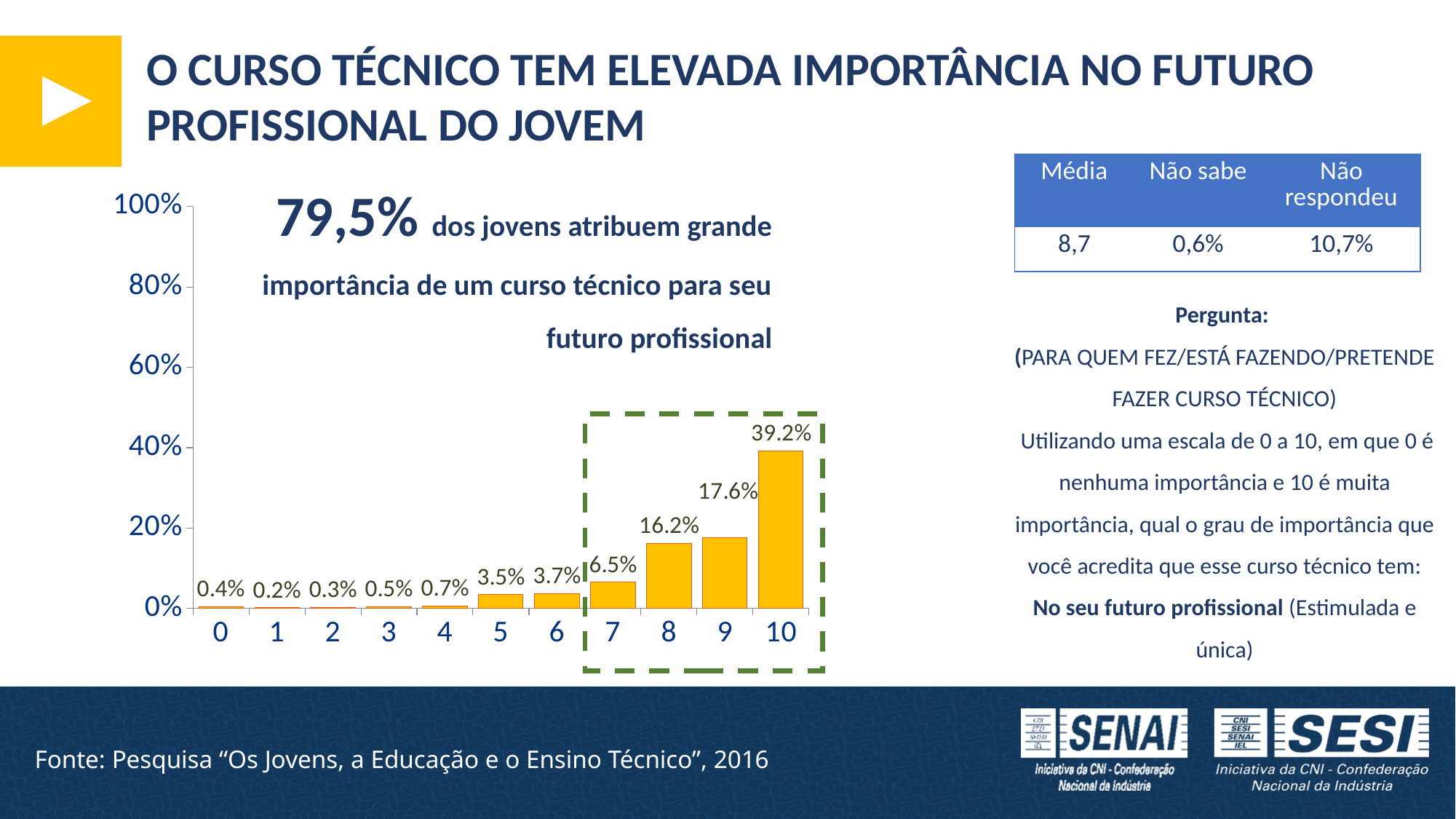
Is the value for category 10 greater or less than 20%? greater How many categories are shown on the x axis? 11 What is the value for category 7? 6.5% What is the difference between the values for categories 10 and 9? 21.6% Which is larger, the value for category 8 or the value for category 9? 9 Which category has the lowest value? 1 What is the value for category 5? 3.5% What is the total of the values for categories 7, 8, 9 and 10? 79.5% What kind of chart is shown on the slide? bar chart Which category has the highest value? 10 Do the values generally rise or fall from category 0 to category 10? rise What is the value for category 10? 39.2%